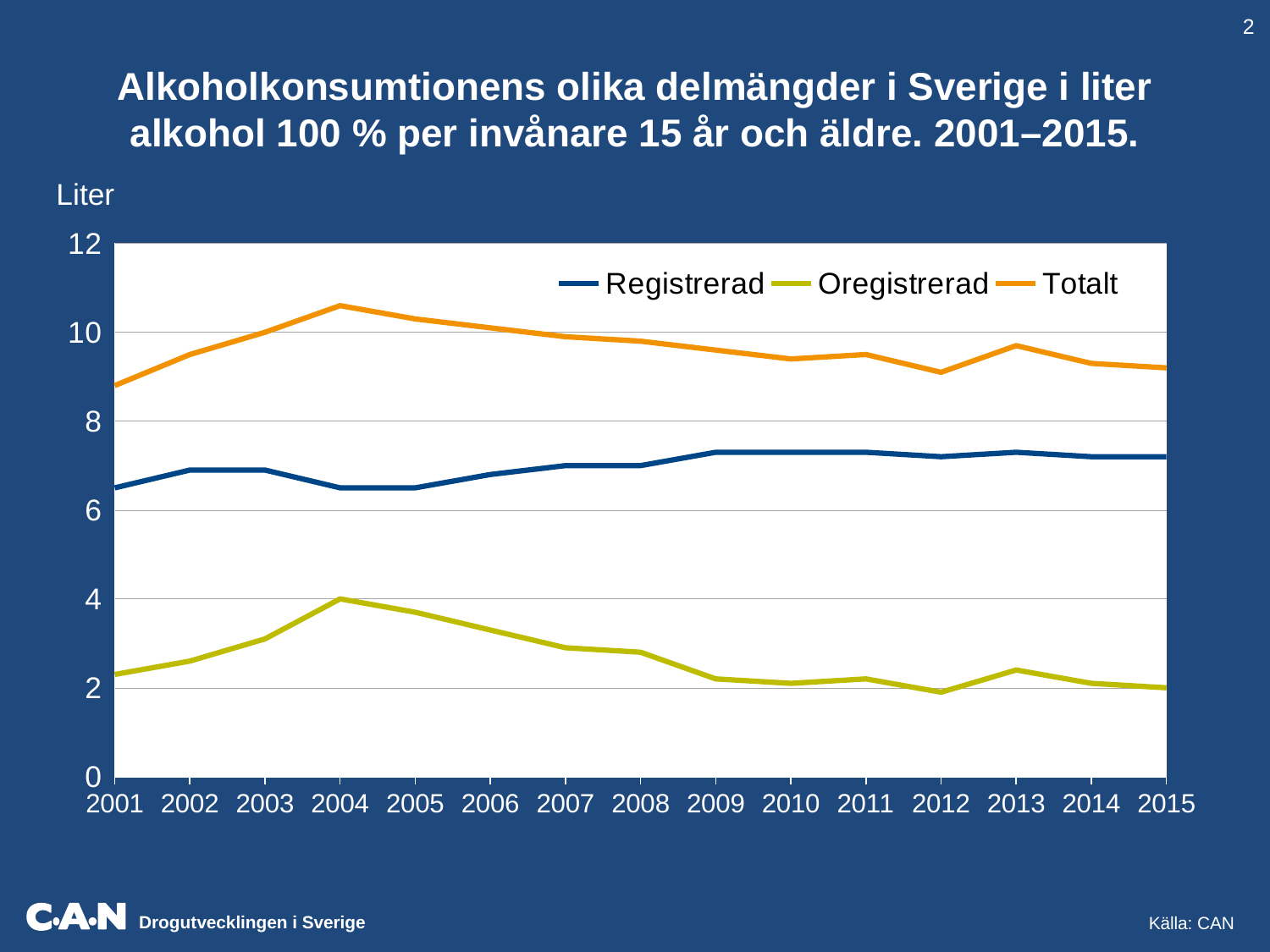
What kind of chart is shown on the slide? line chart How many series does the legend list? 3 Is the value for Oregistrerad in 2007 greater or less than 4? less What label is shown on the y axis of the chart? Liter Does the Oregistrerad series rise or fall between 2004 and 2012? fall In which year is the Totalt series at its lowest value? 2001 Is the value for Registrerad in 2009 greater or less than 6? greater Which is larger, the Totalt value in 2004 or in 2015? 2004 Is the value for Totalt in 2004 greater or less than 10? greater In which year does the Oregistrerad series reach its highest value? 2004 How many years are plotted along the x axis? 15 In which year does the Totalt series reach its highest value? 2004